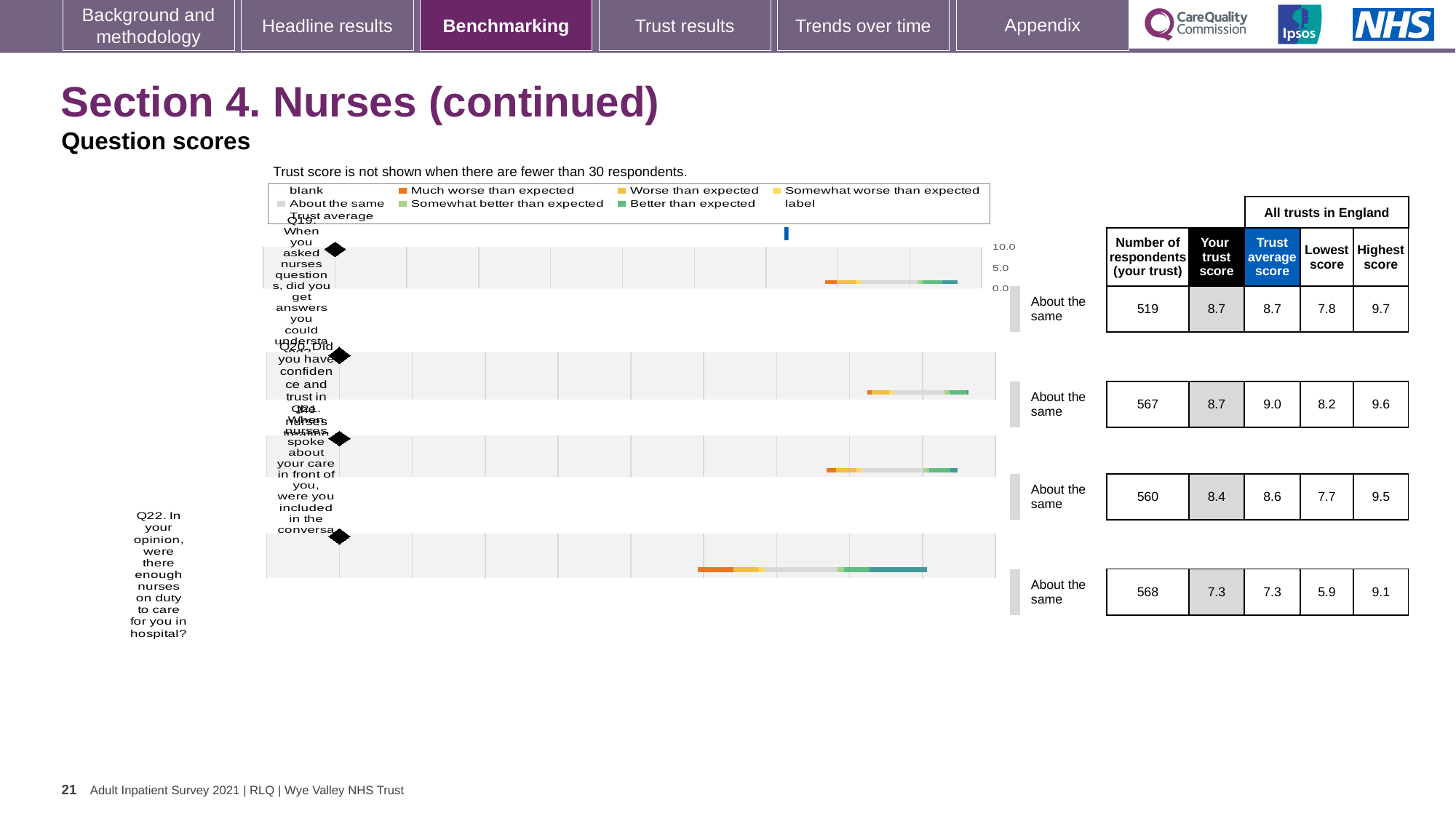
What is the number of respondents (your trust) for Q20? 567 Which question has the lowest 'Your trust score'? Q22 What is the 'Your trust score' for Q19 about getting answers you could understand from nurses? 8.7 Which has the higher trust average score: Q20 (confidence and trust in nurses) or Q21 (included in the conversation)? Q20 What kind of chart is used to show the question scores on this slide? Bar chart How many questions (categories) are plotted in the chart? 4 What benchmark category is shown for Q22? About the same By how much does the trust average score exceed 'Your trust score' for Q20? 0.3 What is the lowest score across all trusts in England for Q22? 5.9 What is the number of respondents (your trust) for Q22 about whether there were enough nurses on duty? 568 What is the highest score across all trusts in England for Q21? 9.5 What is the difference between the highest score and the lowest score for Q22? 3.2